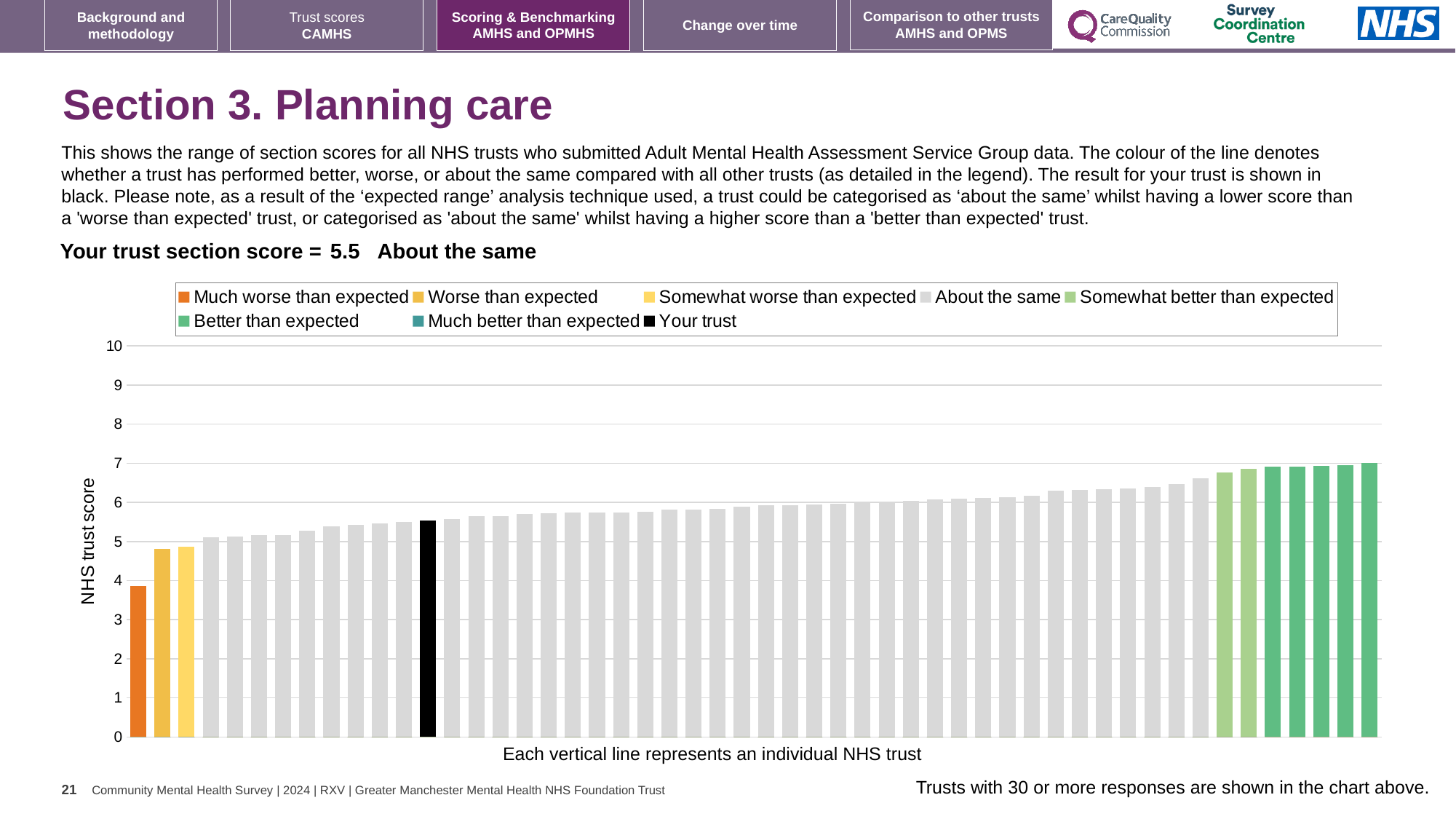
Is the value of the black 'Your trust' bar greater or less than 5? greater Which is larger: the black 'Your trust' bar or the orange 'Much worse than expected' bar? Your trust How many bars are coloured orange ('Much worse than expected')? 1 What is the label on the vertical axis of the chart? NHS trust score What is the section score for your trust shown on the slide? 5.5 Is the value of the orange 'Much worse than expected' bar greater or less than 4? less Which performance category is your trust placed in? About the same Do the bar values rise or fall from left to right along the x axis? rise Is the value of the tallest bar in the chart greater or less than 6? greater How many entries does the chart legend list? 8 Which legend category do the lowest bars in the chart belong to? Much worse than expected What kind of chart is shown on the slide? bar chart